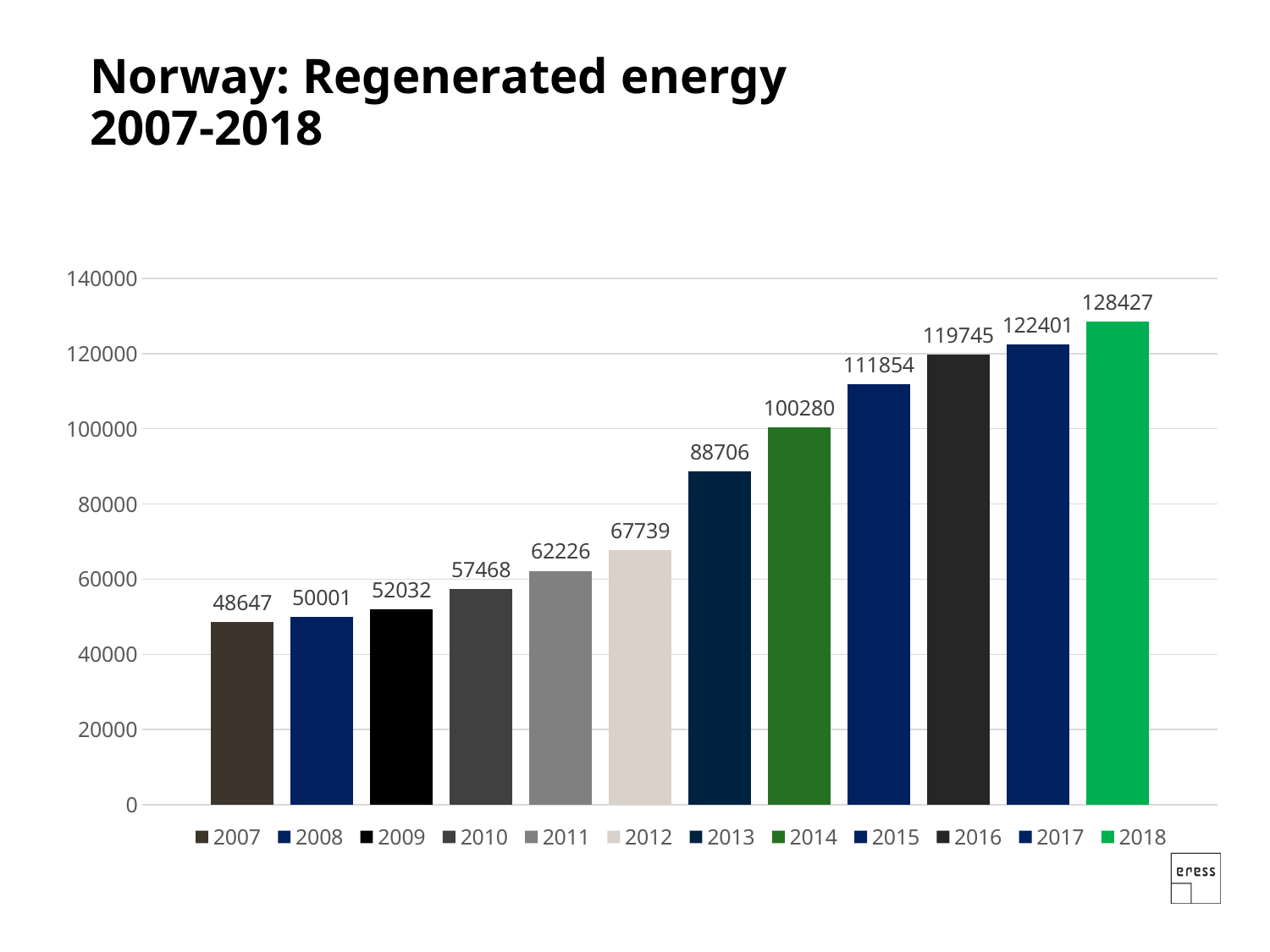
Is the value for 2015 greater or less than 100000? greater What is the difference between the values for 2018 and 2007? 79780 What is the difference between the values for 2014 and 2013? 11574 Which year has the highest regenerated energy value? 2018 What is the regenerated energy value for 2007? 48647 What is the regenerated energy value for 2014? 100280 What is the regenerated energy value for 2018? 128427 What kind of chart is shown on the slide? bar chart Which year has the lowest regenerated energy value? 2007 Do the values rise or fall from 2007 to 2018? rise Which is larger, the value for 2012 or the value for 2013? 2013 How many years are plotted in the chart? 12